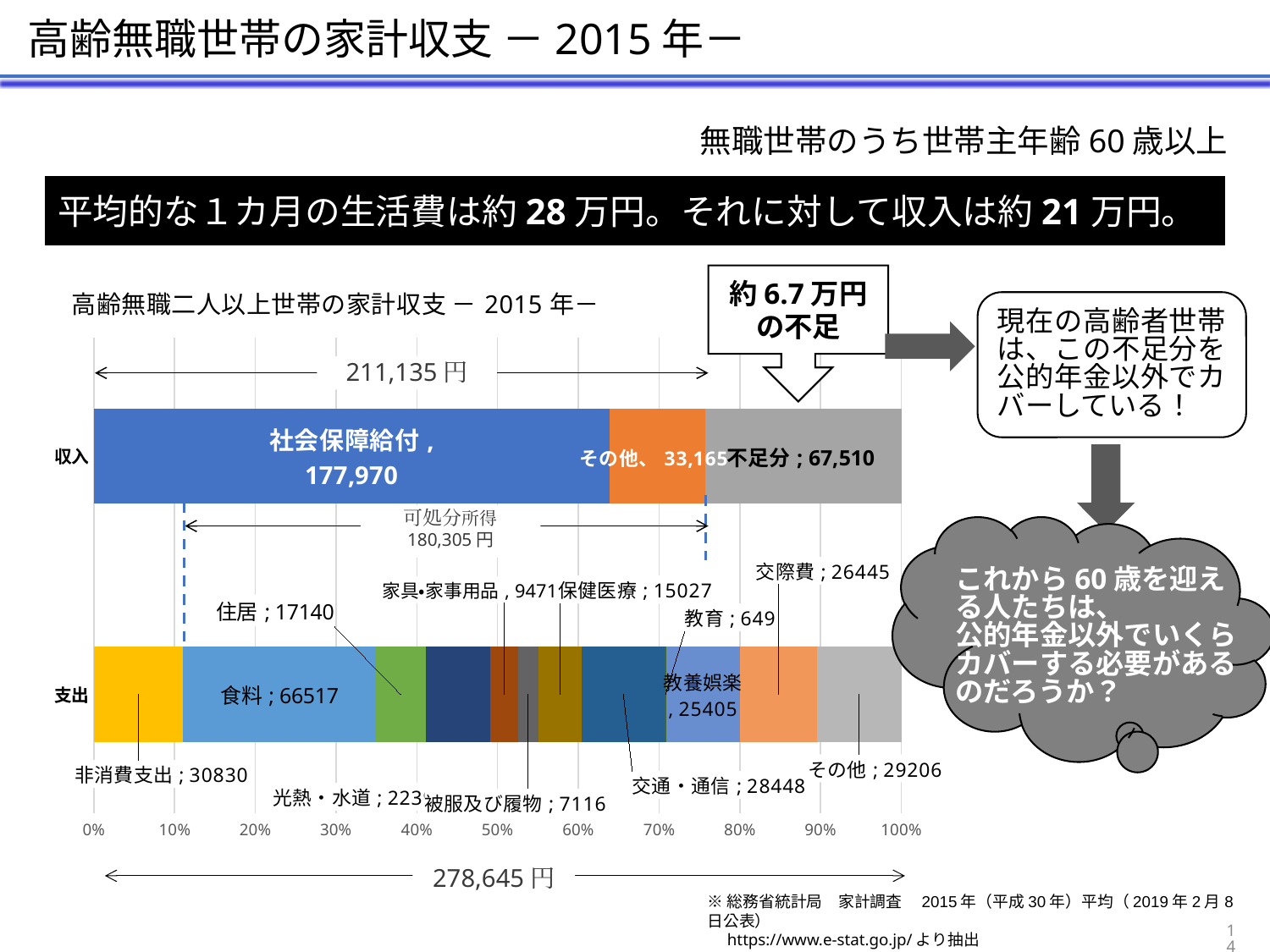
What is the value of 教育 in the 支出 bar? 649 Which is larger in the 支出 bar, 交際費 or 教養娯楽? 交際費 Which segment of the 収入 bar is the largest? 社会保障給付 What is the value of 社会保障給付 in the 収入 bar? 177,970 What kind of chart is shown on the slide? stacked bar chart What is the value of その他 in the 収入 bar? 33,165 Which labelled segment of the 支出 bar is the smallest? 教育 What is the value of 食料 in the 支出 bar? 66517 What is the value of 交通・通信 in the 支出 bar? 28448 What is the value of 不足分 in the 収入 bar? 67,510 What total amount is shown for the 支出 bar? 278,645 円 What is the difference between 保健医療 and 住居 in the 支出 bar? 2113